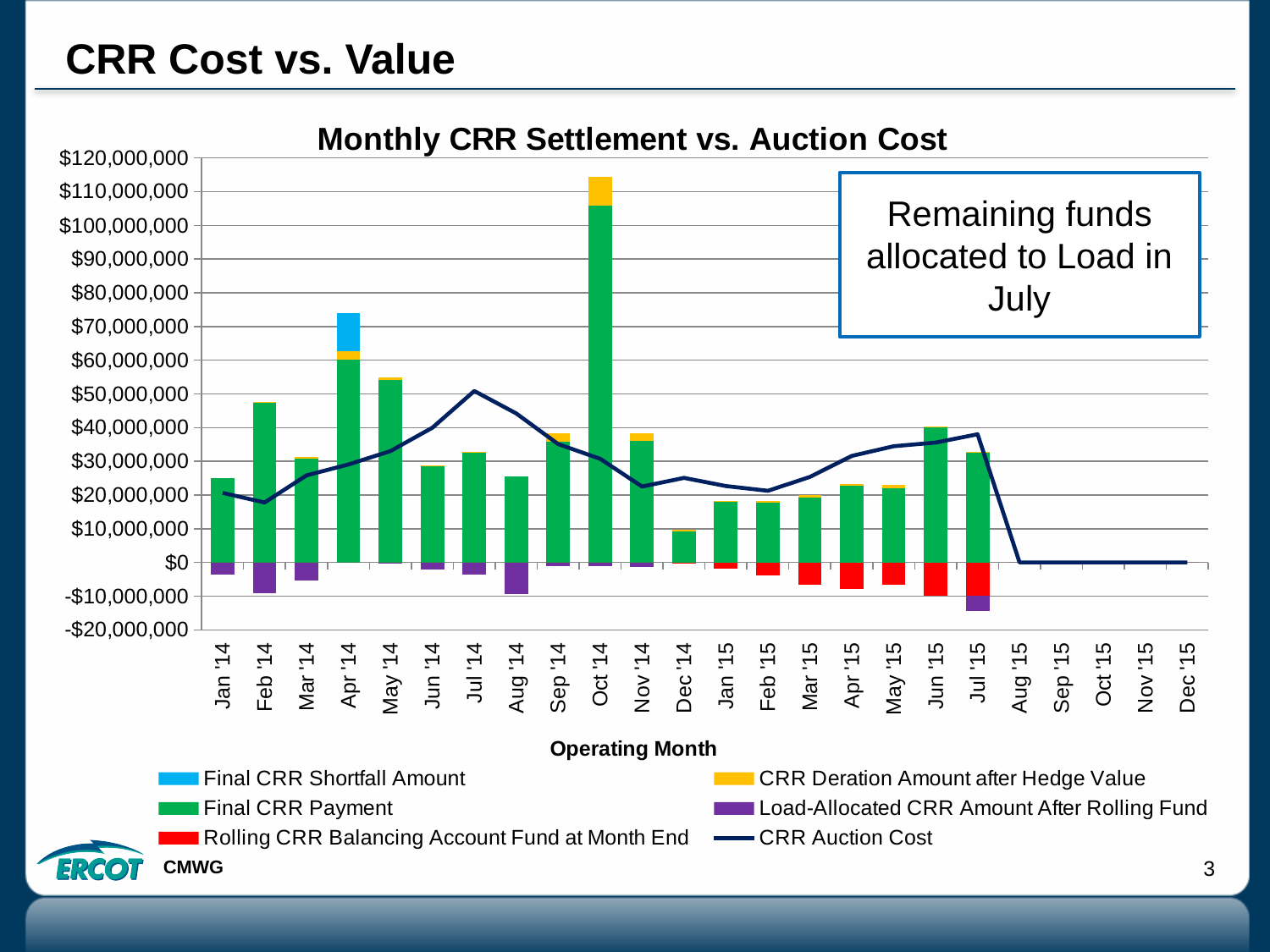
Which is larger, the Final CRR Payment for Feb '14 or for Mar '14? Feb '14 What is the CRR Auction Cost for Dec '15? $0 Is the CRR Auction Cost for Jul '14 greater or less than $40,000,000? greater Is the Final CRR Payment for Feb '14 greater or less than $50,000,000? less How many operating months are shown on the x axis? 24 Does the CRR Auction Cost rise or fall from Jan '15 to Jul '15? rise What kind of chart is shown on the slide? Stacked bar chart with a line series Which operating month has the highest Final CRR Payment? Oct '14 How many series does the chart legend list? 6 Which operating month shows a Final CRR Shortfall Amount? Apr '14 Is the Final CRR Payment for Oct '14 greater or less than $100,000,000? greater What is the title of the chart? Monthly CRR Settlement vs. Auction Cost